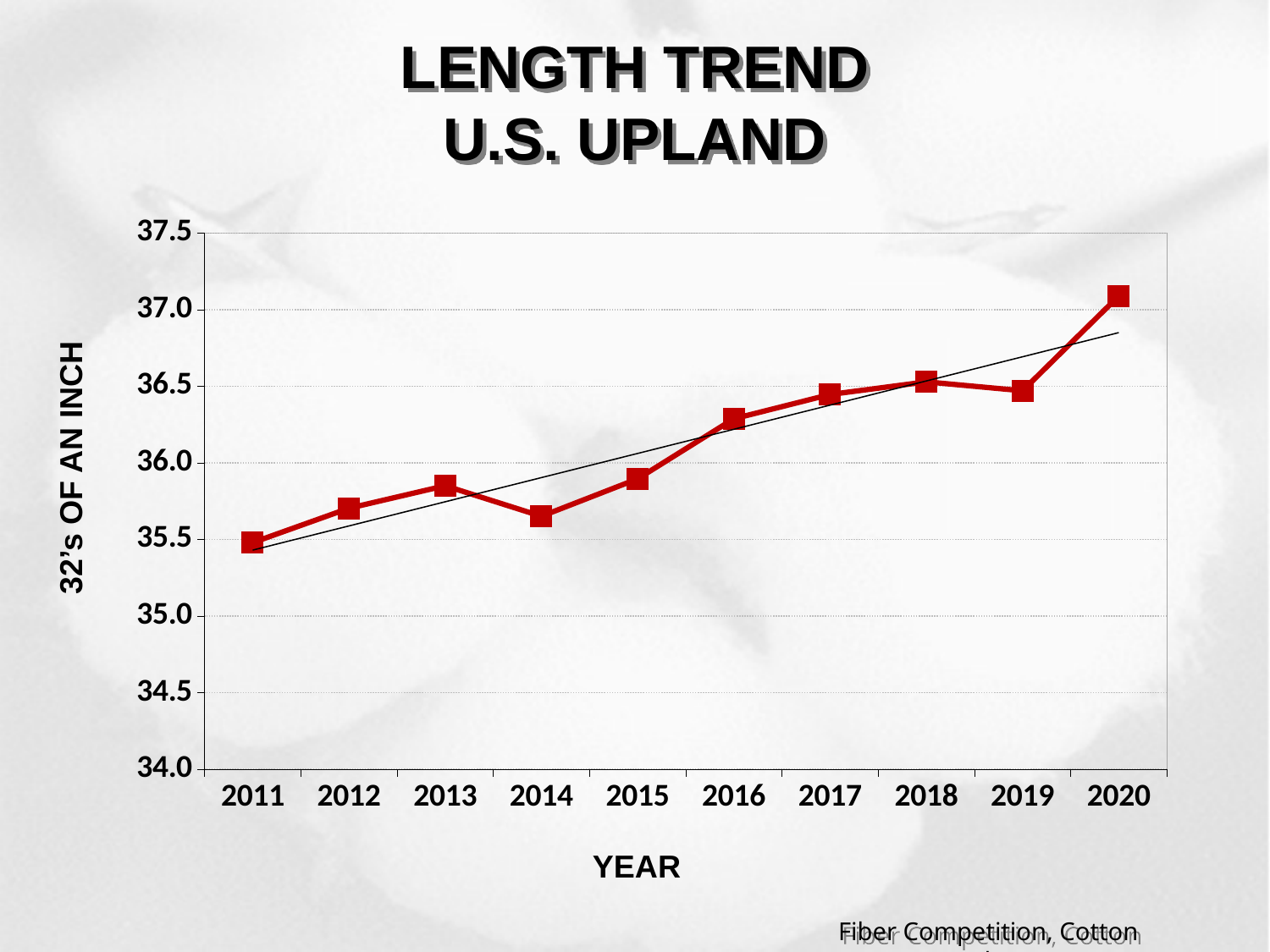
Is the value for 2011 greater or less than 36.0? less Which year has the highest length value? 2020 Which year has the larger value, 2015 or 2016? 2016 Do the values generally rise or fall from 2011 to 2020? rise Which year has the larger value, 2013 or 2014? 2013 Which year has the lowest length value? 2011 How many years are plotted on the x axis? 10 Is the value for 2020 greater or less than 37.0? greater What kind of chart is shown on the slide? line chart Is the value for 2014 greater or less than 36.0? less What is the label on the y axis? 32's OF AN INCH